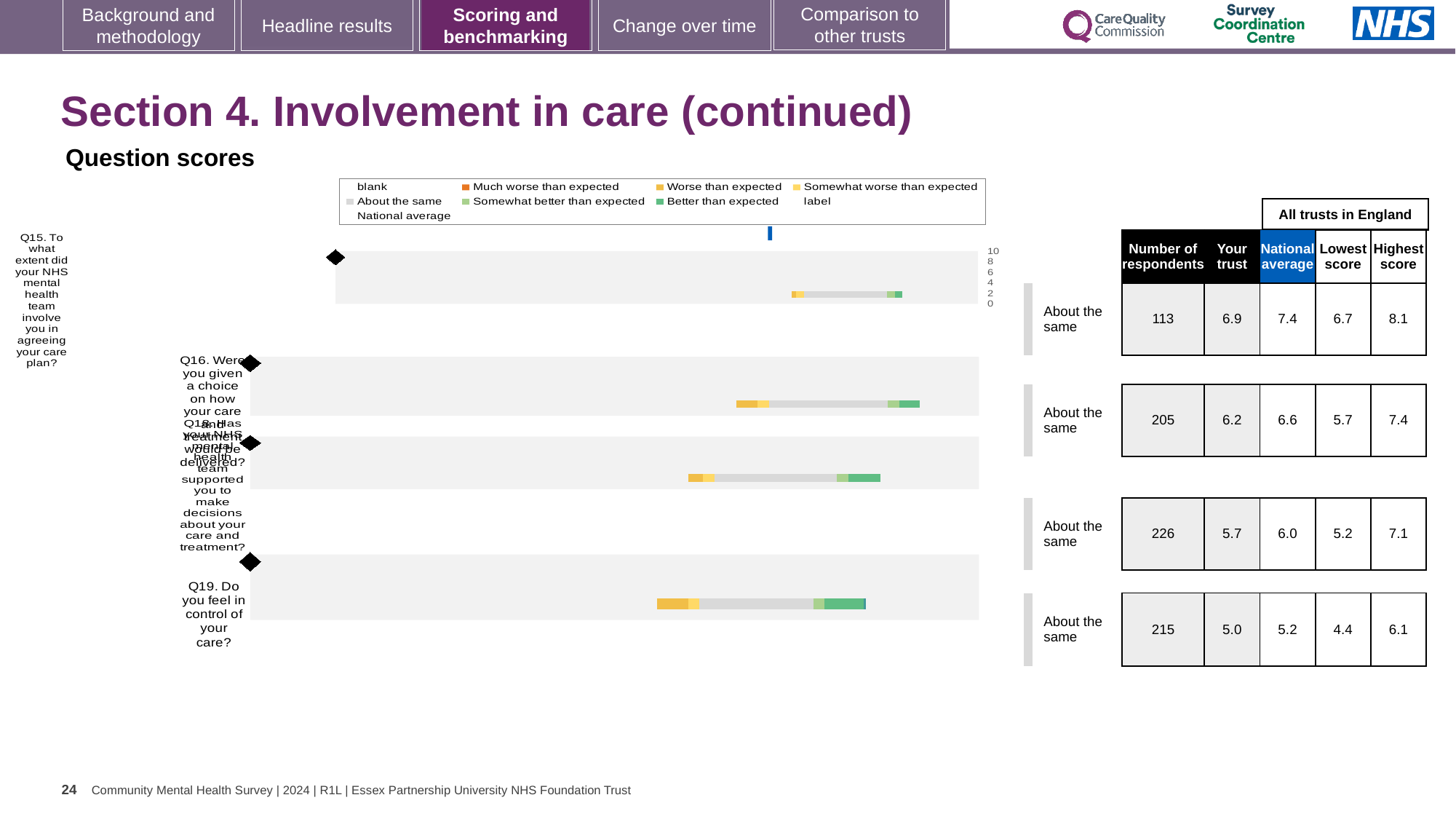
How many questions (categories) are plotted in the question scores chart? 4 What benchmark label is shown next to each of the four question bars in the chart? About the same What kind of chart is used to show the question scores on this slide? bar chart What is the difference between the national average and the 'Your trust' score for Q16 in the table beside the chart? 0.4 Which question has the highest 'Your trust' score in the table beside the chart? Q15 Which legend entry in the question scores chart is shown in orange? Much worse than expected Which question has the lowest 'Your trust' score in the table beside the chart? Q19 In the table beside the chart, what is the national average for Q19 (Do you feel in control of your care?)? 5.2 How many entries does the legend of the question scores chart list? 9 In the table beside the chart, what is the 'Your trust' score for Q15 (involving you in agreeing your care plan)? 6.9 In the table beside the chart, how many respondents answered Q18? 226 What is the heading given above the question scores chart? Question scores